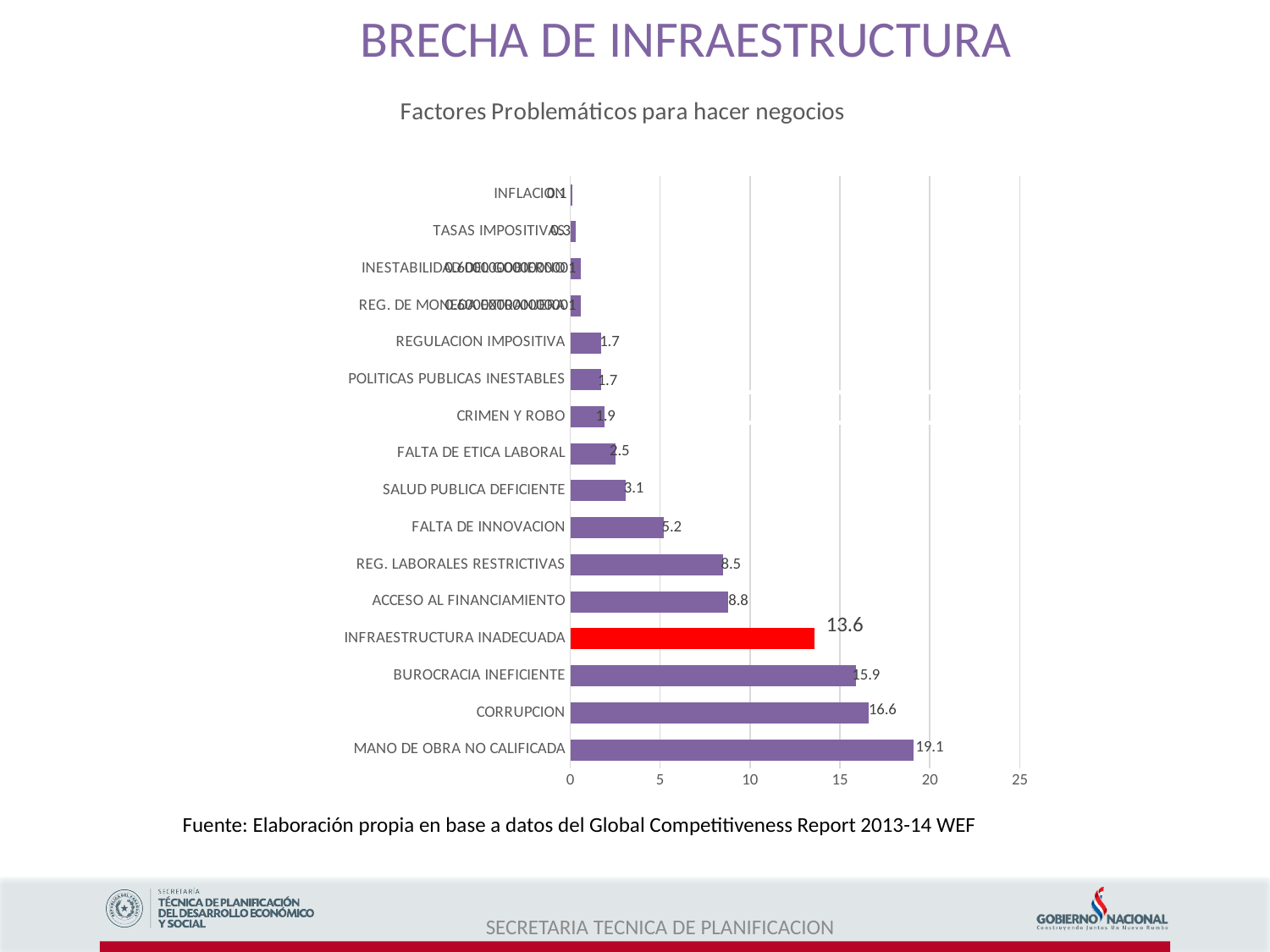
Which category has the highest value? MANO DE OBRA NO CALIFICADA What is the value for INFRAESTRUCTURA INADECUADA? 13.6 What is the value for FALTA DE INNOVACION? 5.2 What is the difference between INFRAESTRUCTURA INADECUADA and ACCESO AL FINANCIAMIENTO? 4.8 What is the value for MANO DE OBRA NO CALIFICADA? 19.1 Is the value for REG. LABORALES RESTRICTIVAS greater or less than 10? less Which category has the lowest value? INFLACION What kind of chart is shown on the slide? bar chart Which is larger, CORRUPCION or BUROCRACIA INEFICIENTE? CORRUPCION How many categories are shown in the chart? 16 What is the value for CORRUPCION? 16.6 What is the difference between MANO DE OBRA NO CALIFICADA and CORRUPCION? 2.5